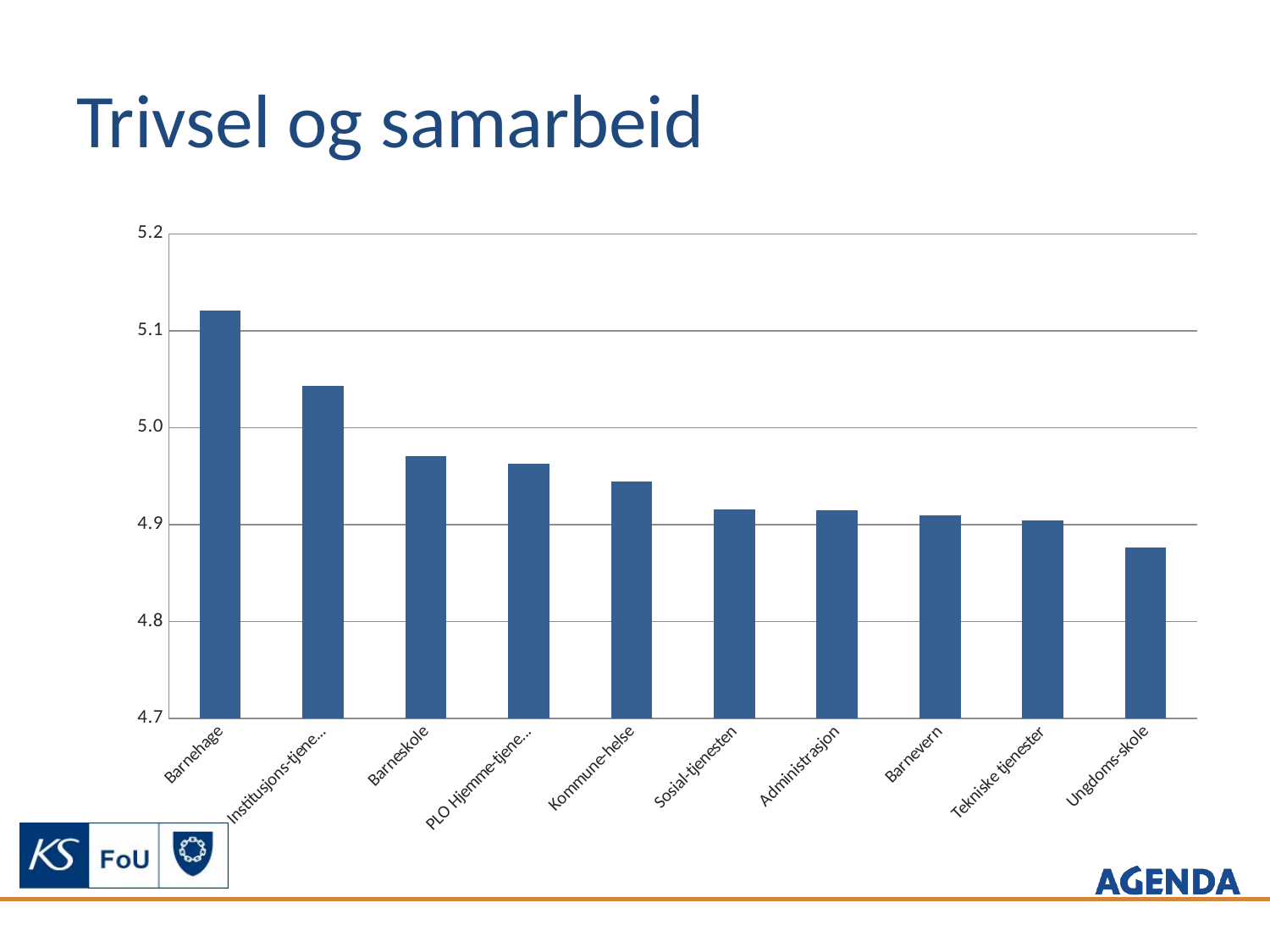
Which is larger, the value for Barneskole or the value for Kommune-helse? Barneskole Is the value for Barnehage greater or less than 5.0? greater How many categories are plotted in the chart? 10 Which category has the highest value? Barnehage What is the title of the slide? Trivsel og samarbeid Which is larger, the value for Barnehage or the value for Ungdoms-skole? Barnehage What kind of chart is shown on the slide? bar chart Is the value for Ungdoms-skole greater or less than 4.9? less Is the value for Barneskole greater or less than 5.0? less Which category has the lowest value? Ungdoms-skole Do the values rise or fall from left to right along the x axis? fall